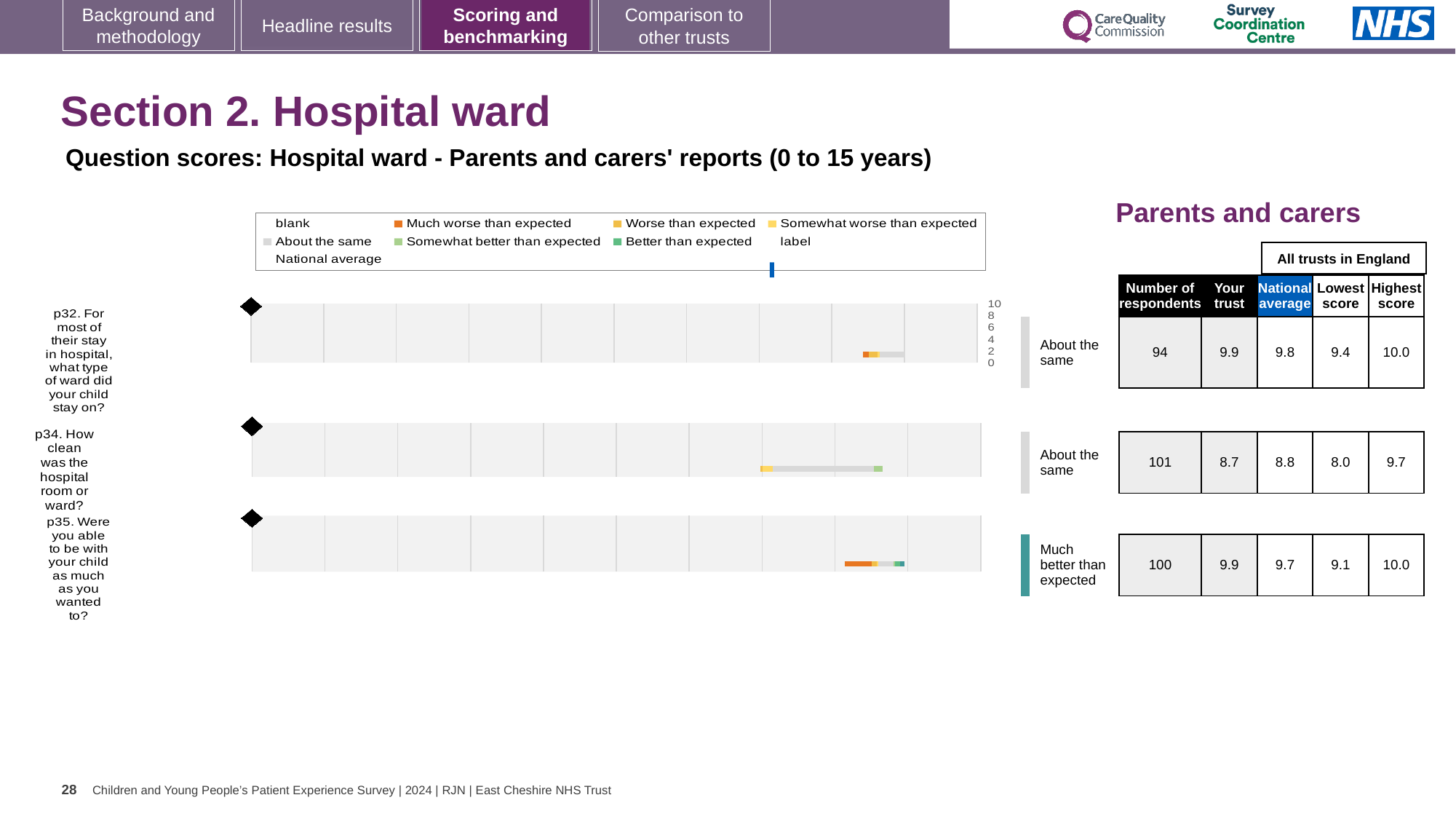
How many questions (p32, p34, p35) are plotted on the slide? 3 How many respondents answered p35 (Were you able to be with your child as much as you wanted to?)? 100 What is the national average score for p32 (what type of ward did your child stay on?)? 9.8 What kind of chart is used to show the question scores for p32, p34 and p35? bar chart What is the lowest score among all trusts in England for p35? 9.1 What is the difference between the highest score and the lowest score for p34? 1.7 For p34, which is higher: the 'Your trust' score or the national average? National average What is the 'Your trust' score for p34 (How clean was the hospital room or ward?)? 8.7 Which benchmark category is shown for p35 (Were you able to be with your child as much as you wanted to?)? Much better than expected For p32, which is higher: the 'Your trust' score or the national average? Your trust Which question has the lowest 'Your trust' score? p34 What is the highest score among all trusts in England for p34? 9.7